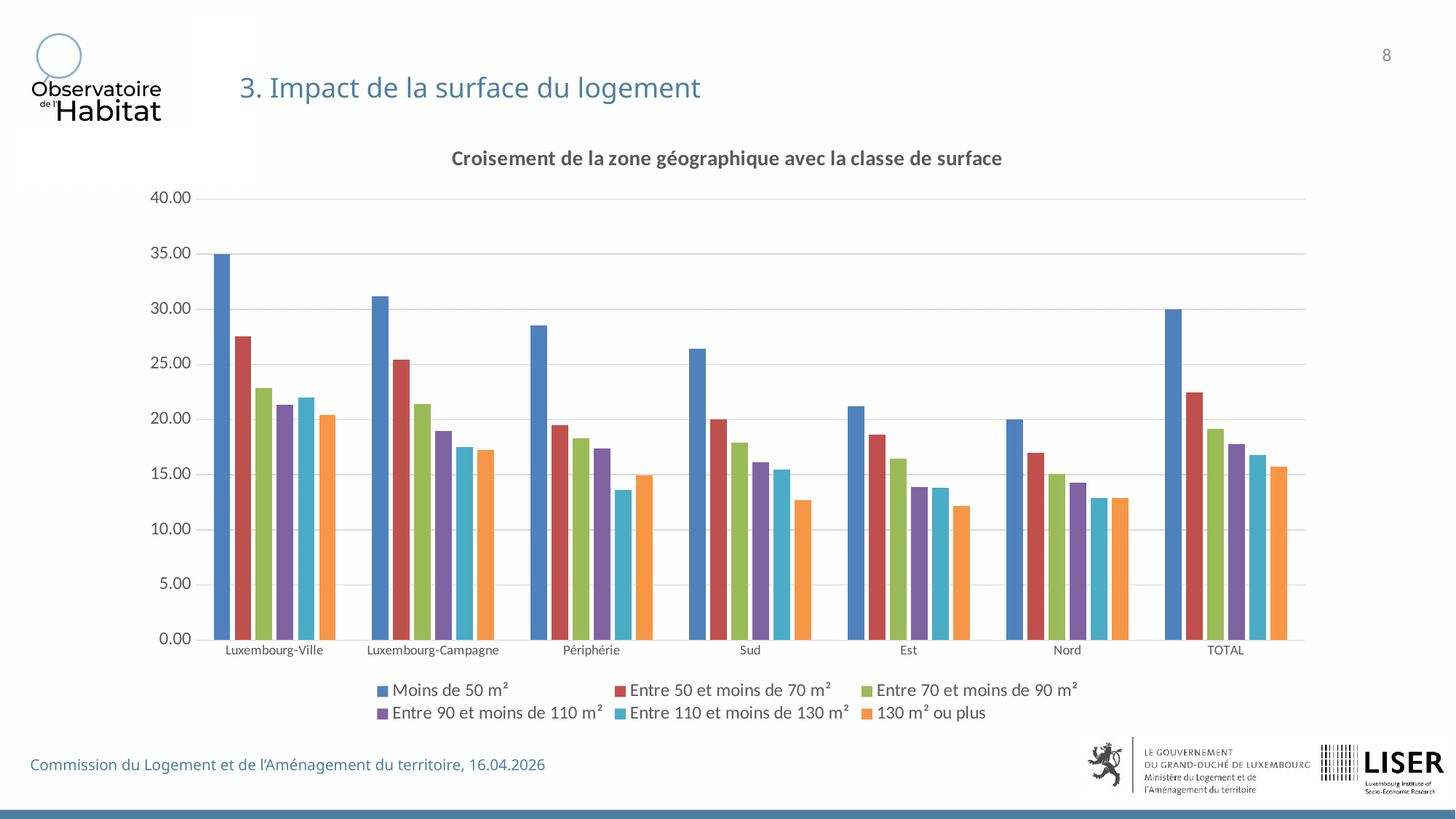
What is the title of the chart? Croisement de la zone géographique avec la classe de surface Which is larger for Moins de 50 m²: Sud or Est? Sud Is the value for 130 m² ou plus in Est greater or less than 15? less Is the value for Moins de 50 m² in Luxembourg-Ville greater or less than 30? greater Is the value for Entre 110 et moins de 130 m² in Périphérie greater or less than 15? less How many series does the legend list? 6 How many categories are shown on the x axis? 7 Which surface class has the lowest value in Sud? 130 m² ou plus What kind of chart is shown on the slide? bar chart In which zone is the Moins de 50 m² series highest? Luxembourg-Ville Does the Moins de 50 m² series rise or fall from Luxembourg-Ville to Nord? fall